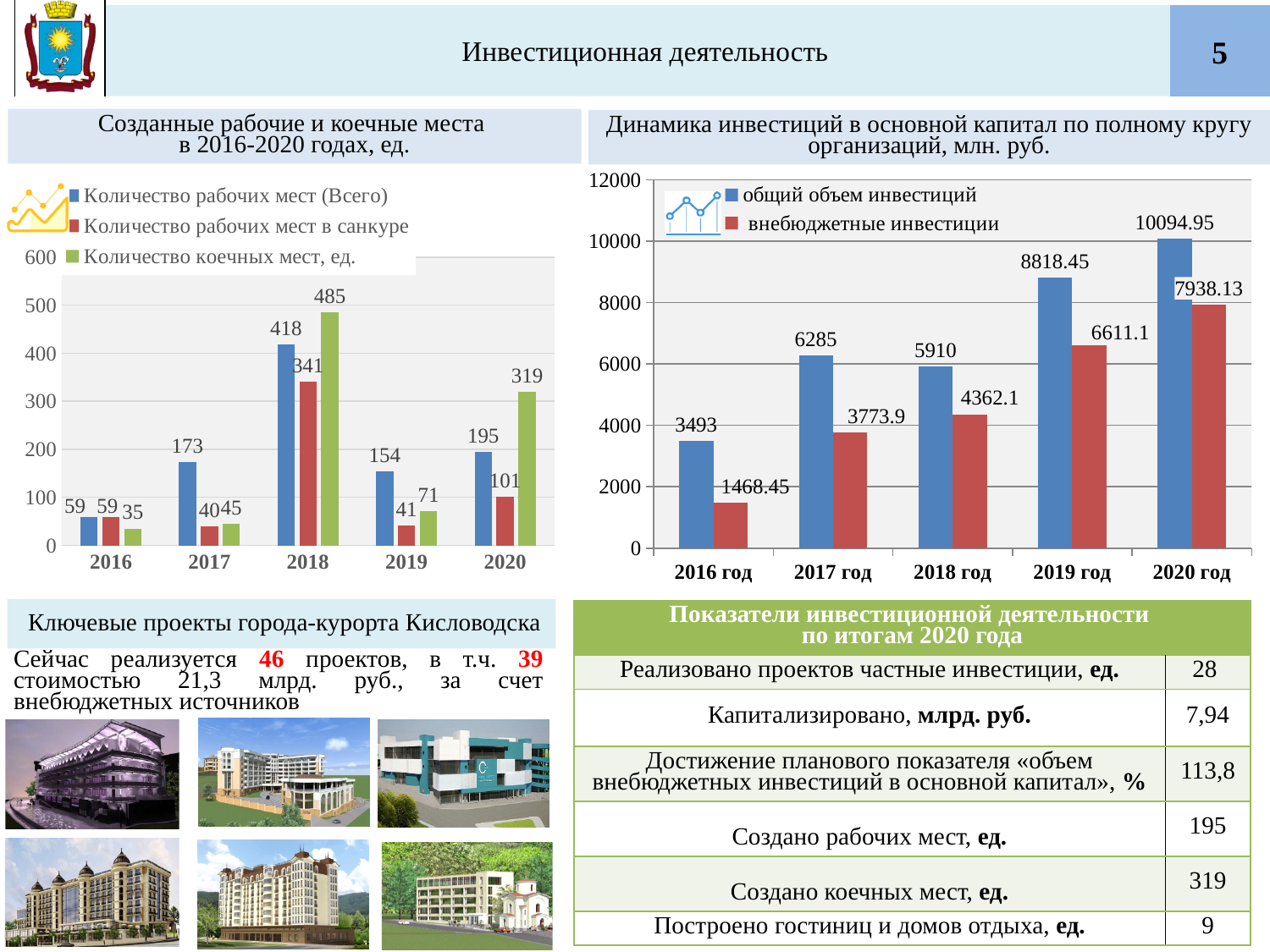
In the chart 'Созданные рабочие и коечные места в 2016-2020 годах, ед.', which year has the highest value for 'Количество коечных мест, ед.'? 2018 In the chart 'Динамика инвестиций в основной капитал по полному кругу организаций, млн. руб.', what is the value of 'внебюджетные инвестиции' for 2017 год? 3773.9 In the chart 'Созданные рабочие и коечные места в 2016-2020 годах, ед.', what is the difference between 'Количество рабочих мест (Всего)' in 2018 and in 2019? 264 In the chart 'Созданные рабочие и коечные места в 2016-2020 годах, ед.', what is the value of 'Количество коечных мест, ед.' for 2020? 319 How many series does the legend of the chart 'Созданные рабочие и коечные места в 2016-2020 годах, ед.' list? 3 In the chart 'Динамика инвестиций в основной капитал по полному кругу организаций, млн. руб.', which is larger: 'общий объем инвестиций' in 2017 год or in 2018 год? 2017 год In the chart 'Динамика инвестиций в основной капитал по полному кругу организаций, млн. руб.', how many years are shown on the x axis? 5 In the chart 'Созданные рабочие и коечные места в 2016-2020 годах, ед.', which year has the lowest value for 'Количество рабочих мест (Всего)'? 2016 What type of chart is 'Динамика инвестиций в основной капитал по полному кругу организаций, млн. руб.'? Bar chart In the chart 'Динамика инвестиций в основной капитал по полному кругу организаций, млн. руб.', what is the value of 'общий объем инвестиций' for 2020 год? 10094.95 In the chart 'Динамика инвестиций в основной капитал по полному кругу организаций, млн. руб.', which year has the lowest value for 'внебюджетные инвестиции'? 2016 год In the chart 'Созданные рабочие и коечные места в 2016-2020 годах, ед.', what is the value of 'Количество рабочих мест (Всего)' for 2018? 418